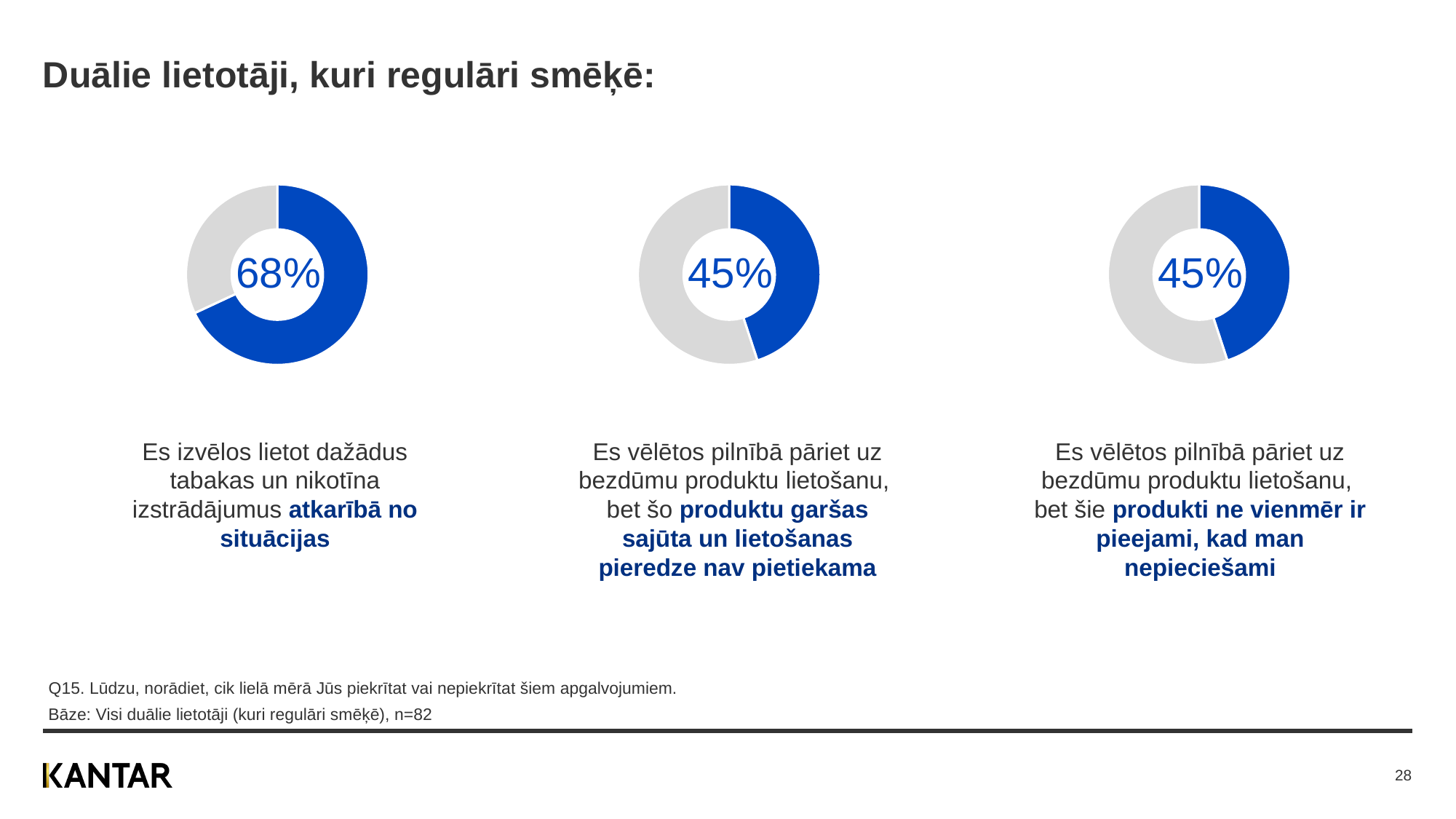
What kind of charts are shown on the slide? Doughnut (pie) charts What colour is used for the highlighted (value) segment in each doughnut chart? Blue What is the base size (n) stated for the charts on the slide? n=82 What percentage is shown in the left doughnut chart ("Es izvēlos lietot dažādus tabakas un nikotīna izstrādājumus atkarībā no situācijas")? 68% Which is larger: the value in the left doughnut chart or the value in the middle doughnut chart? The left doughnut chart (68%) Do the middle and right doughnut charts show the same value? Yes, both 45% In the left doughnut chart, what share of the ring is the grey (remaining) segment? 32% What is the difference in percentage points between the left doughnut chart (68%) and the middle doughnut chart (45%)? 23 percentage points What percentage is shown in the middle doughnut chart ("...produktu garšas sajūta un lietošanas pieredze nav pietiekama")? 45% How many doughnut charts are on the slide? 3 Which of the three statements has the highest percentage? Es izvēlos lietot dažādus tabakas un nikotīna izstrādājumus atkarībā no situācijas (68%) What percentage is shown in the right doughnut chart ("...produkti ne vienmēr ir pieejami, kad man nepieciešami")? 45%